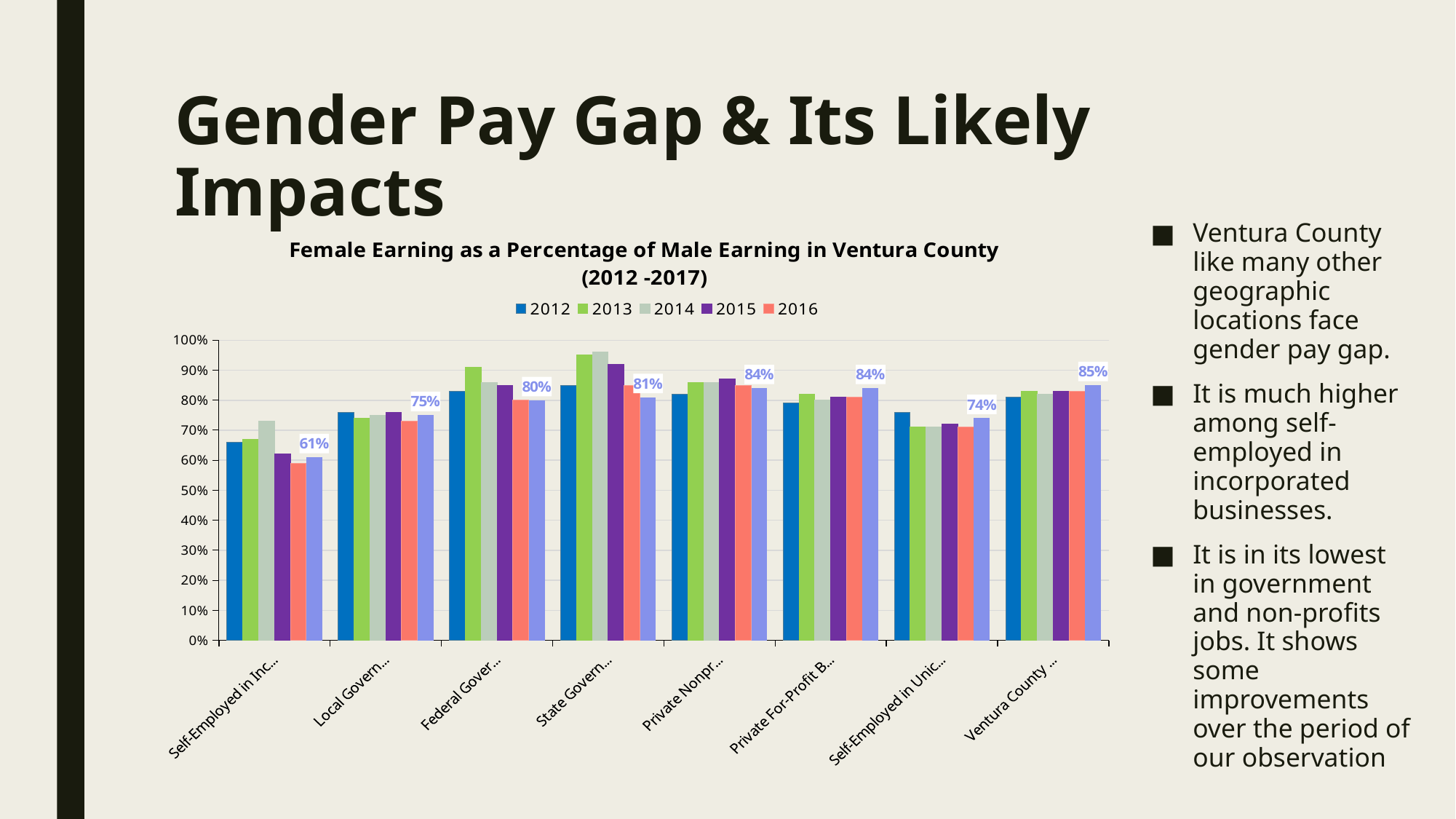
Which has the larger printed data label: 'Local Govern...' or 'Self-Employed in Unic...'? Local Govern... What is the title of the chart? Female Earning as a Percentage of Male Earning in Ventura County (2012 -2017) What value is printed on the labelled (rightmost, light blue) bar in the 'Ventura County ...' group? 85% Is the 2015 bar for 'Self-Employed in Inc...' greater or less than 70%? less How many series does the chart's legend list? 5 Which category group has the lowest printed data label? Self-Employed in Inc... What value is printed on the labelled (rightmost, light blue) bar in the 'Self-Employed in Inc...' group? 61% Is the 2013 bar for 'State Govern...' greater or less than 90%? greater What is the difference between the printed labels for 'Ventura County ...' (85%) and 'Self-Employed in Inc...' (61%)? 24 percentage points Which category group has the highest printed data label? Ventura County ... How many category groups are shown along the x axis of the chart? 8 What kind of chart is shown on the slide? Bar chart